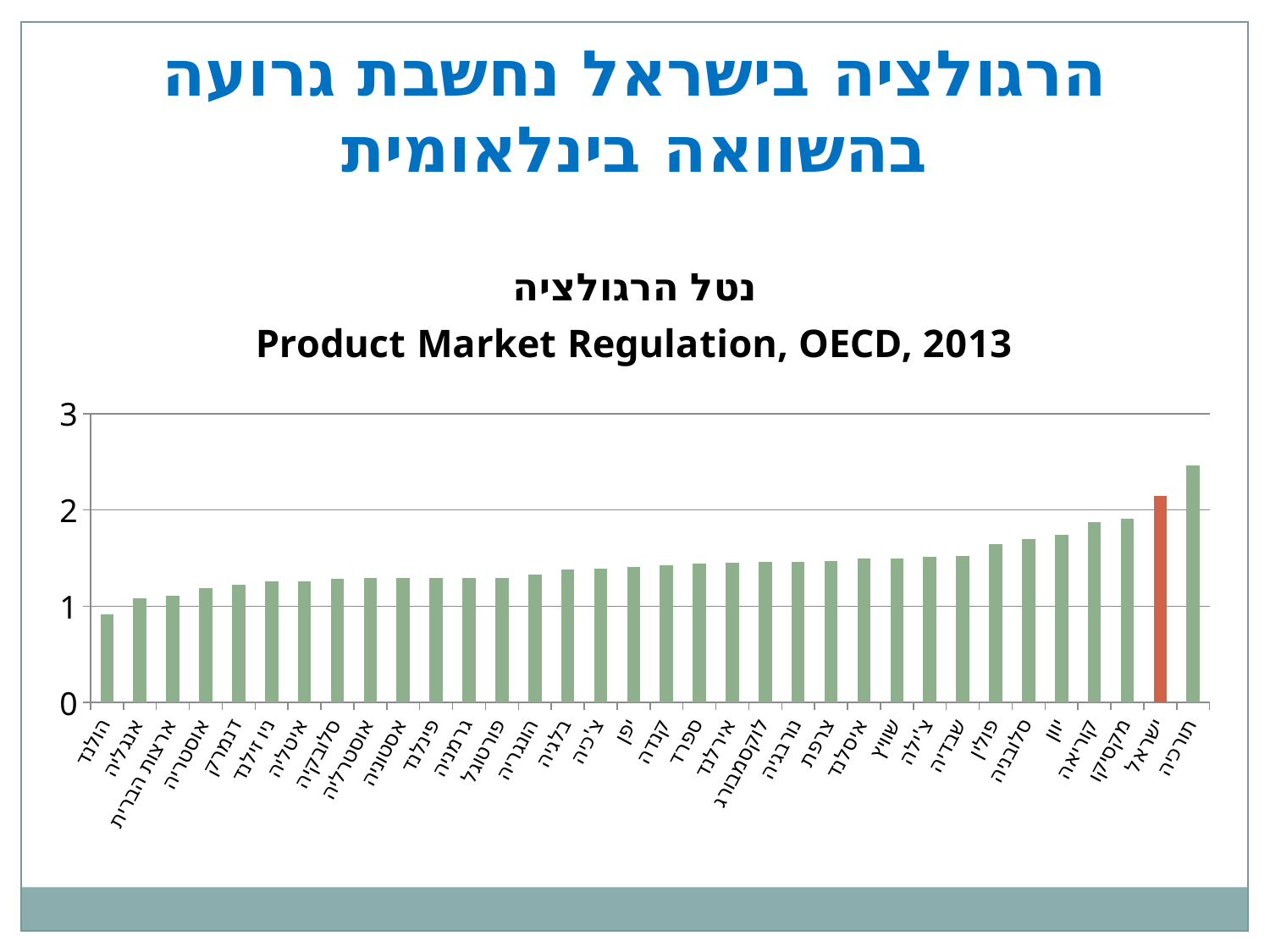
Do the bar values rise or fall from left to right along the x axis? rise Which has a larger value, ישראל or טורקיה? תורכיה Is the value for יפן greater or less than 1? greater Which country has the highest value in the chart? תורכיה Is the value for הולנד greater or less than 1? less What kind of chart is shown on the slide? bar chart Which has a larger value, הולנד or מקסיקו? מקסיקו Which country's bar is highlighted in a different colour (red/orange) from the others? ישראל Is the value for יוון greater or less than 2? less Which country has the lowest value in the chart? הולנד